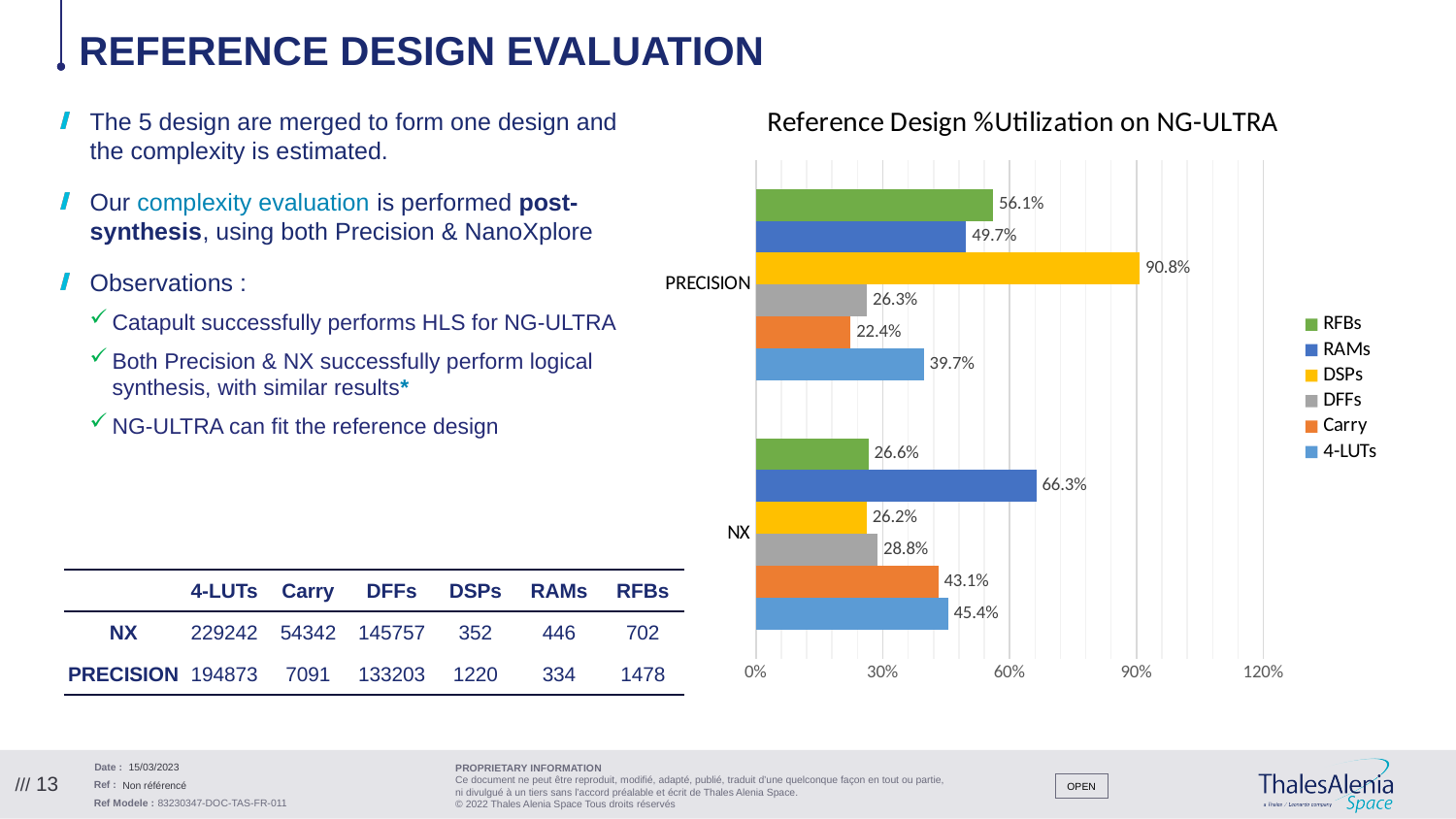
How many series does the legend list? 6 What is the RAMs utilization for NX? 66.3% What is the 4-LUTs utilization for PRECISION? 39.7% Which series has the highest utilization for PRECISION? DSPs What kind of chart is shown on the slide? Bar chart What is the Carry utilization for NX? 43.1% What is the title of the chart? Reference Design %Utilization on NG-ULTRA What is the difference between the DSPs utilization for PRECISION and for NX? 64.6% Which series has the lowest utilization for PRECISION? Carry What is the DSPs utilization for PRECISION? 90.8% Which is larger, the RFBs utilization for PRECISION or for NX? PRECISION Which series has the highest utilization for NX? RAMs